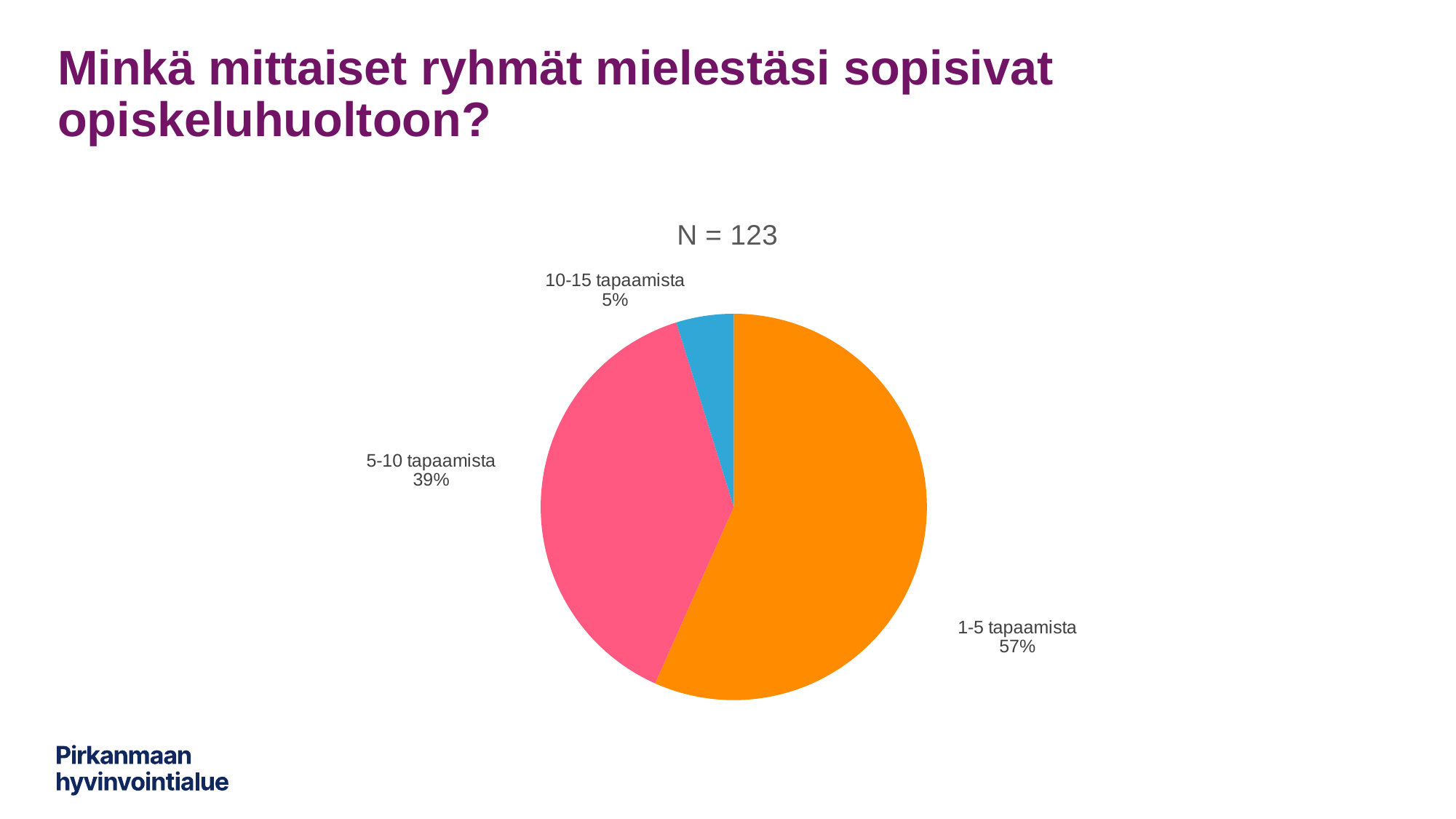
What share of the pie does "5-10 tapaamista" represent? 39% Which is larger, the share for "5-10 tapaamista" or the share for "10-15 tapaamista"? 5-10 tapaamista Which category has the smallest slice of the pie? 10-15 tapaamista What is the difference in percentage points between "5-10 tapaamista" and "10-15 tapaamista"? 34 What colour is the slice for "1-5 tapaamista"? orange What type of chart is shown on the slide? pie chart Which category has the largest slice of the pie? 1-5 tapaamista What is the title shown above the pie chart? N = 123 How many categories are shown in the pie chart? 3 What share of the pie does "10-15 tapaamista" represent? 5% What share of the pie does "1-5 tapaamista" represent? 57% What is the difference in percentage points between "1-5 tapaamista" and "5-10 tapaamista"? 18